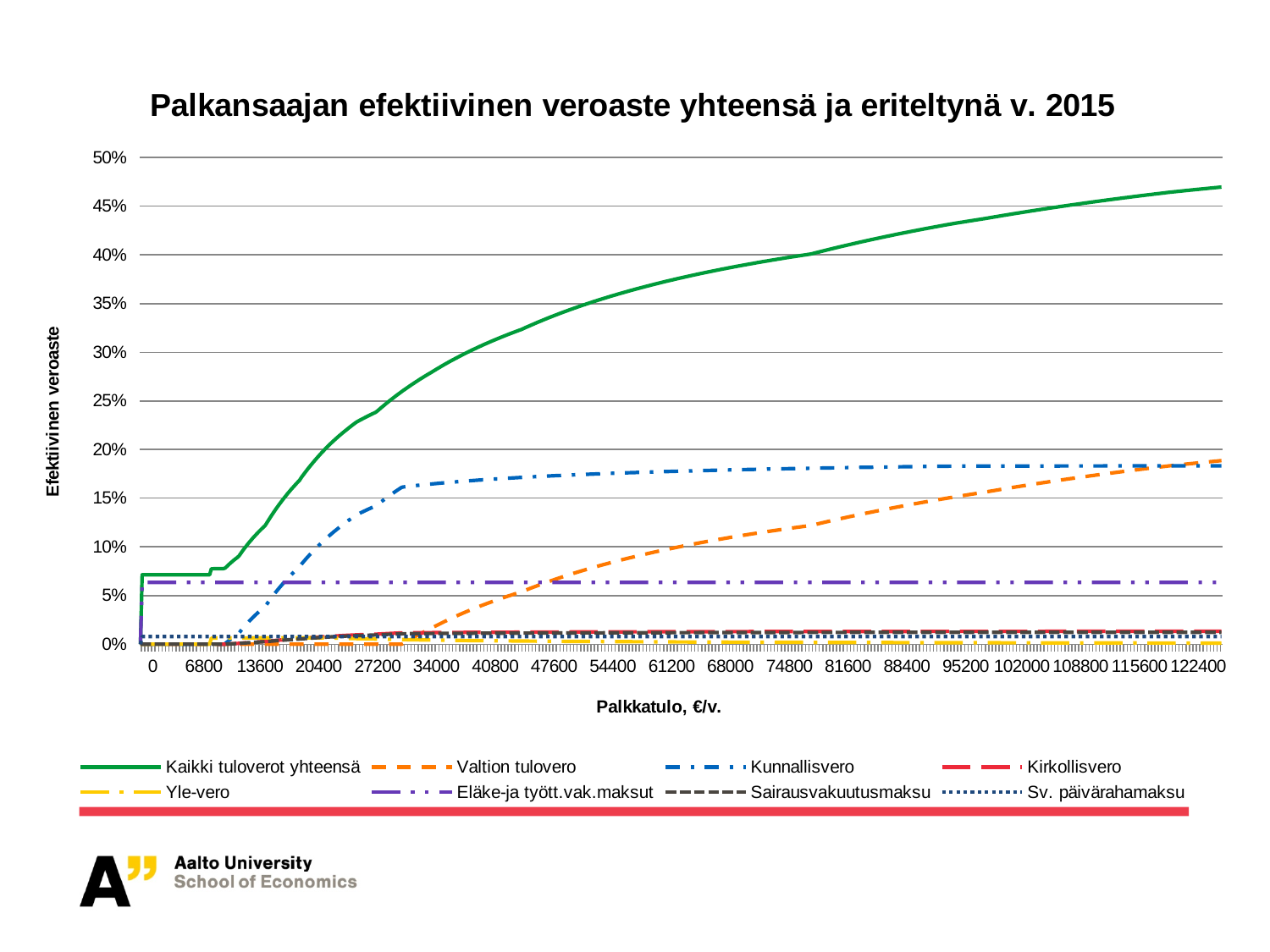
What is the label of the x axis? Palkkatulo, €/v. Does the Kaikki tuloverot yhteensä line rise or fall as Palkkatulo increases? rise Is the value of Kaikki tuloverot yhteensä at 122400 greater or less than 45%? greater Is the value of Eläke-ja tyött.vak.maksut at 68000 greater or less than 10%? less How many series does the legend list? 8 Is the value of Valtion tulovero at 27200 greater or less than 5%? less Which series has the lowest value at 122400? Yle-vero What kind of chart is shown on the slide? line chart What is the title of the chart? Palkansaajan efektiivinen veroaste yhteensä ja eriteltynä v. 2015 At 40800, which is larger: Kunnallisvero or Valtion tulovero? Kunnallisvero Which series has the highest value at 122400? Kaikki tuloverot yhteensä